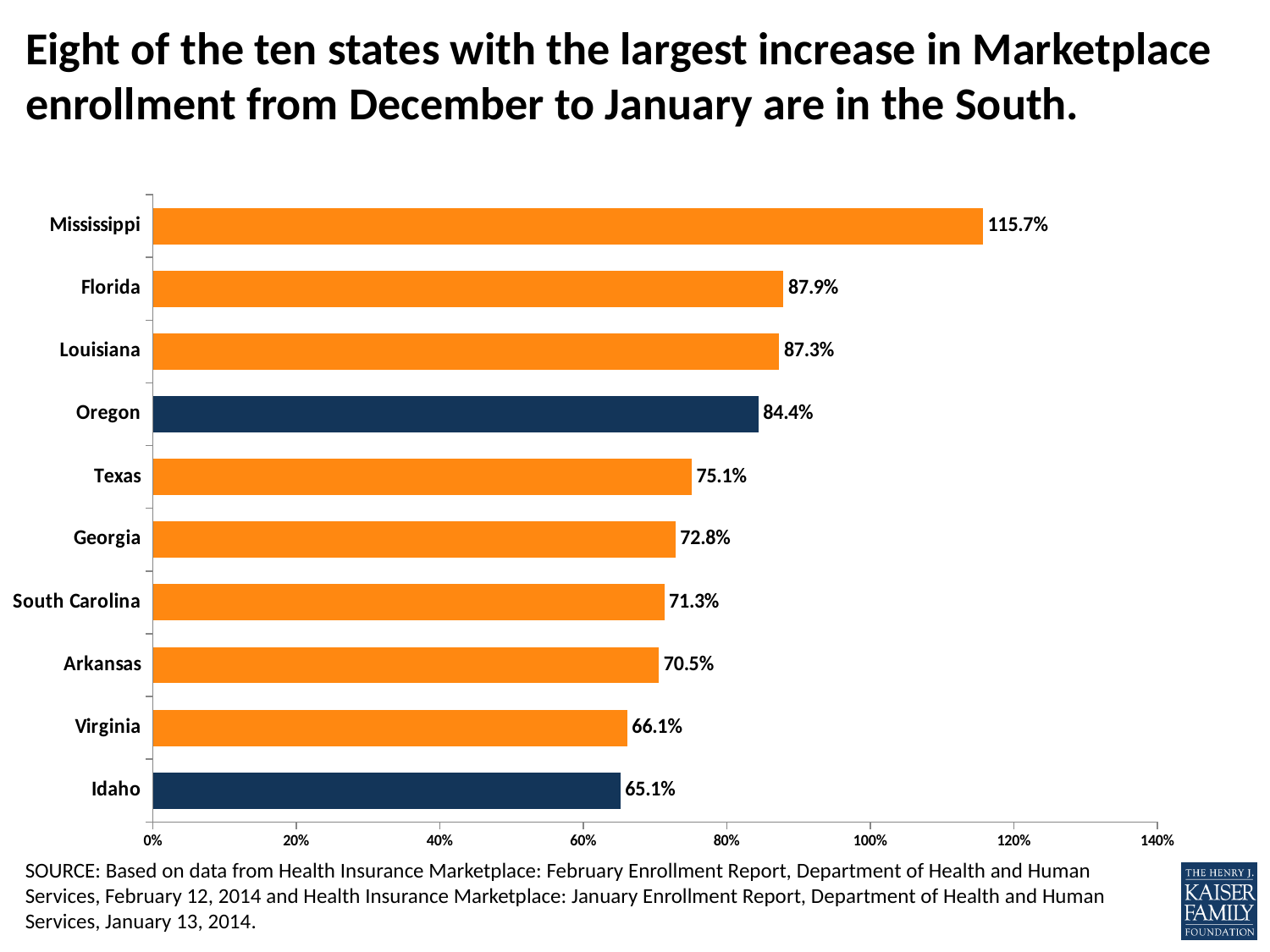
Which state has the lowest value? Idaho What is the value for Oregon? 84.4% What kind of chart is shown on the slide? bar chart What is the difference between the values for Mississippi and Florida? 27.8% What is the difference between the values for Texas and Georgia? 2.3% Which two states are shown with dark blue bars instead of orange? Oregon and Idaho What is the value for Mississippi? 115.7% Which state has the highest value? Mississippi Which is larger, the value for Oregon or the value for Texas? Oregon What is the value for Arkansas? 70.5% Is the value for Virginia greater or less than 80%? less How many states are shown in the chart? 10